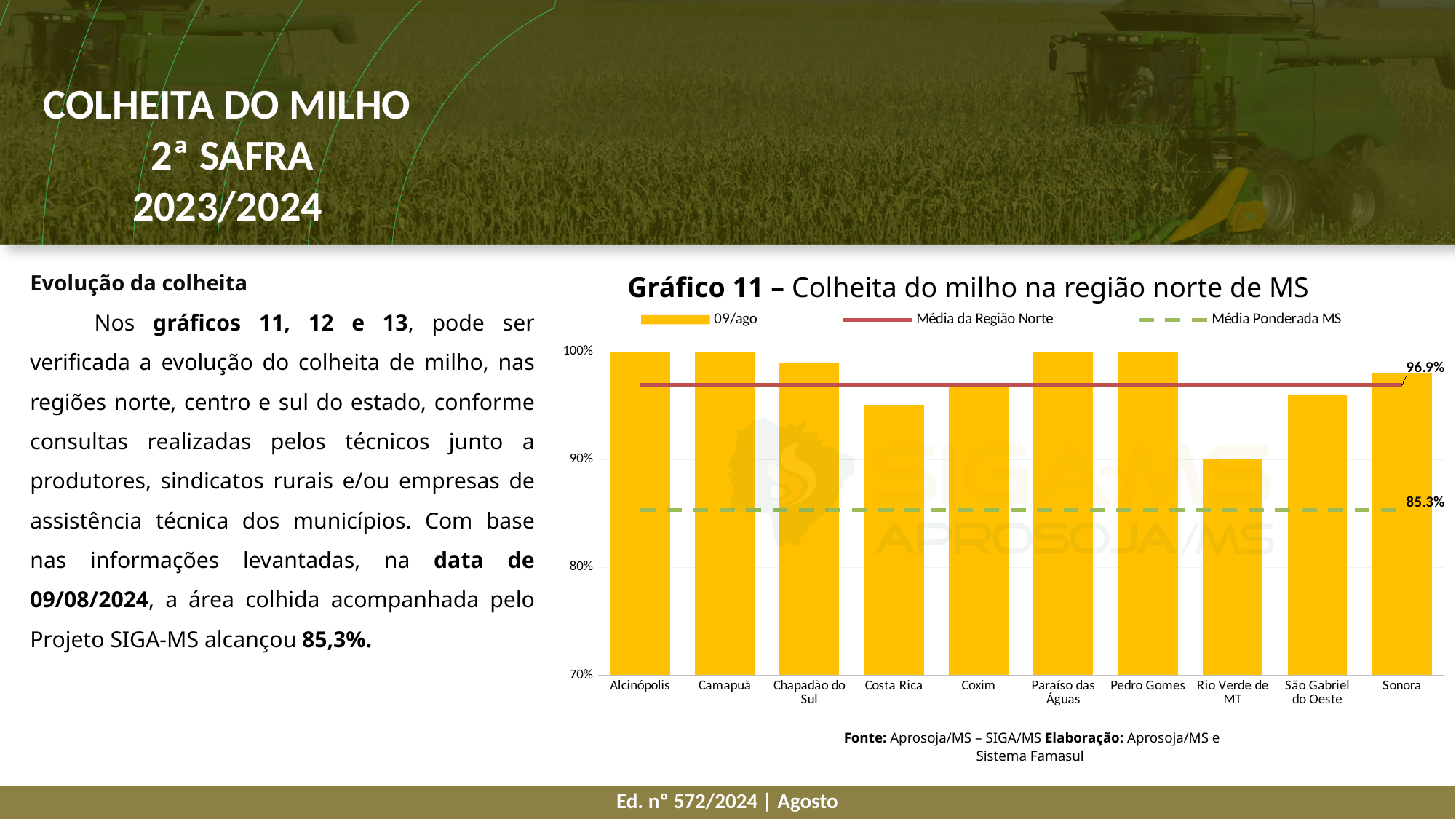
In Gráfico 11, which is larger, the bar for Coxim or the bar for Rio Verde de MT? Coxim How many municipalities are shown on the x axis of Gráfico 11? 10 What kind of chart is Gráfico 11? combination bar and line chart What value is labelled for the Média da Região Norte line in Gráfico 11? 96.9% How many series does the legend of Gráfico 11 list? 3 Which municipality has the lowest bar in Gráfico 11? Rio Verde de MT What is the title of the chart on the slide? Gráfico 11 – Colheita do milho na região norte de MS What legend label is given to the yellow bars in Gráfico 11? 09/ago What value is labelled for the Média Ponderada MS line in Gráfico 11? 85.3% In Gráfico 11, what is the difference between the Média da Região Norte (96.9%) and the Média Ponderada MS (85.3%)? 11.6 percentage points In Gráfico 11, is the value for Costa Rica greater or less than 90%? greater In Gráfico 11, is the value for Rio Verde de MT greater or less than 95%? less